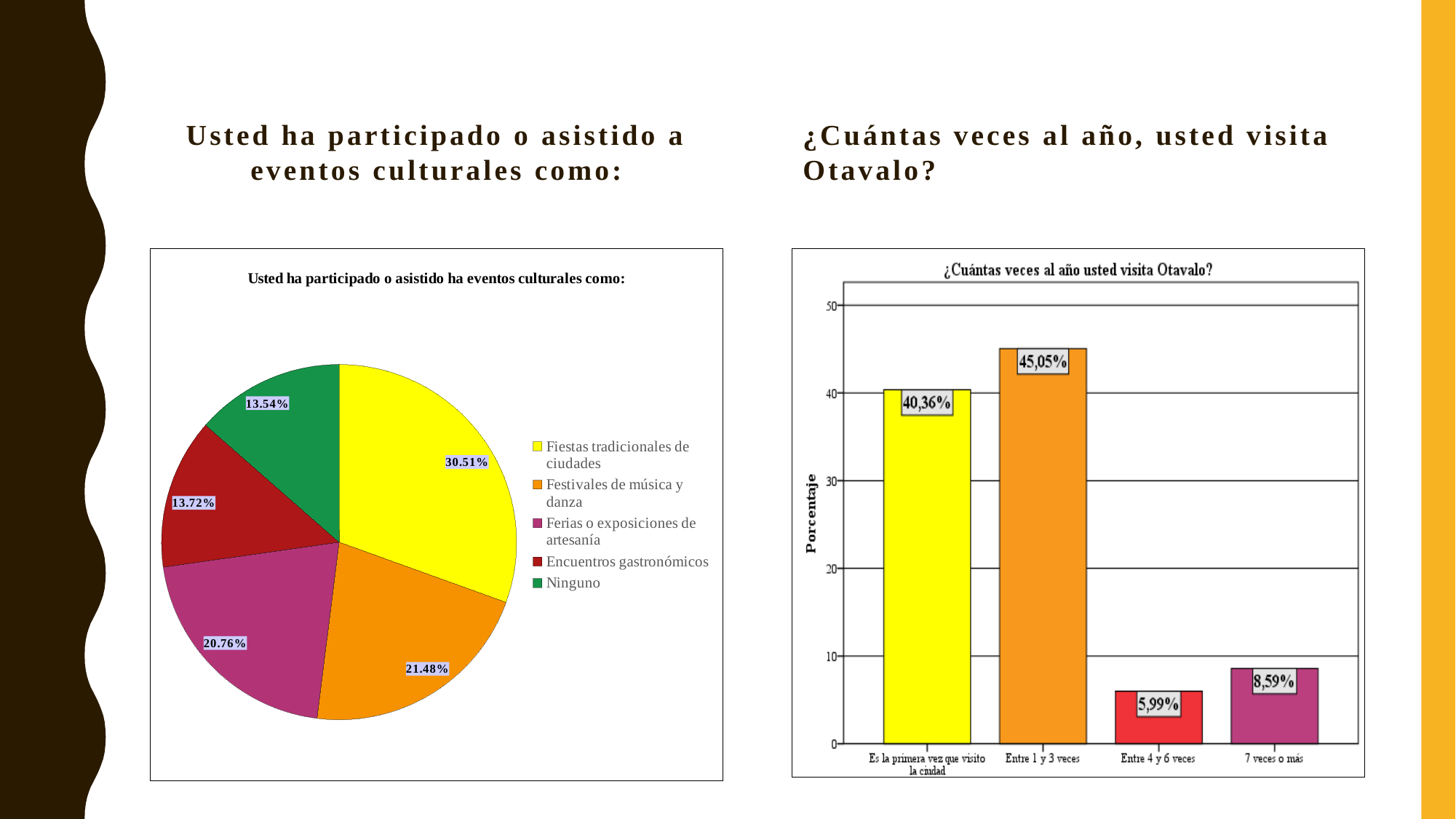
In the bar chart on the right, what is the value for Entre 1 y 3 veces? 45,05% What kind of chart is the chart on the right? Bar chart In the pie chart on the left, what percentage is shown for Fiestas tradicionales de ciudades? 30.51% In the bar chart on the right, what is the label of the y axis? Porcentaje In the bar chart on the right, what is the difference between Entre 1 y 3 veces and Es la primera vez que visito la ciudad? 4,69% In the bar chart on the right, what is the value for Entre 4 y 6 veces? 5,99% In the pie chart on the left, which category has the largest slice? Fiestas tradicionales de ciudades In the pie chart on the left, what percentage is shown for Ferias o exposiciones de artesanía? 20.76% In the pie chart on the left, what is the difference between the Fiestas tradicionales de ciudades slice and the Festivales de música y danza slice? 9.03% In the pie chart on the left, how many slices does the pie have? 5 In the pie chart on the left, which is larger: Festivales de música y danza or Ninguno? Festivales de música y danza In the bar chart on the right, which category has the lowest value? Entre 4 y 6 veces